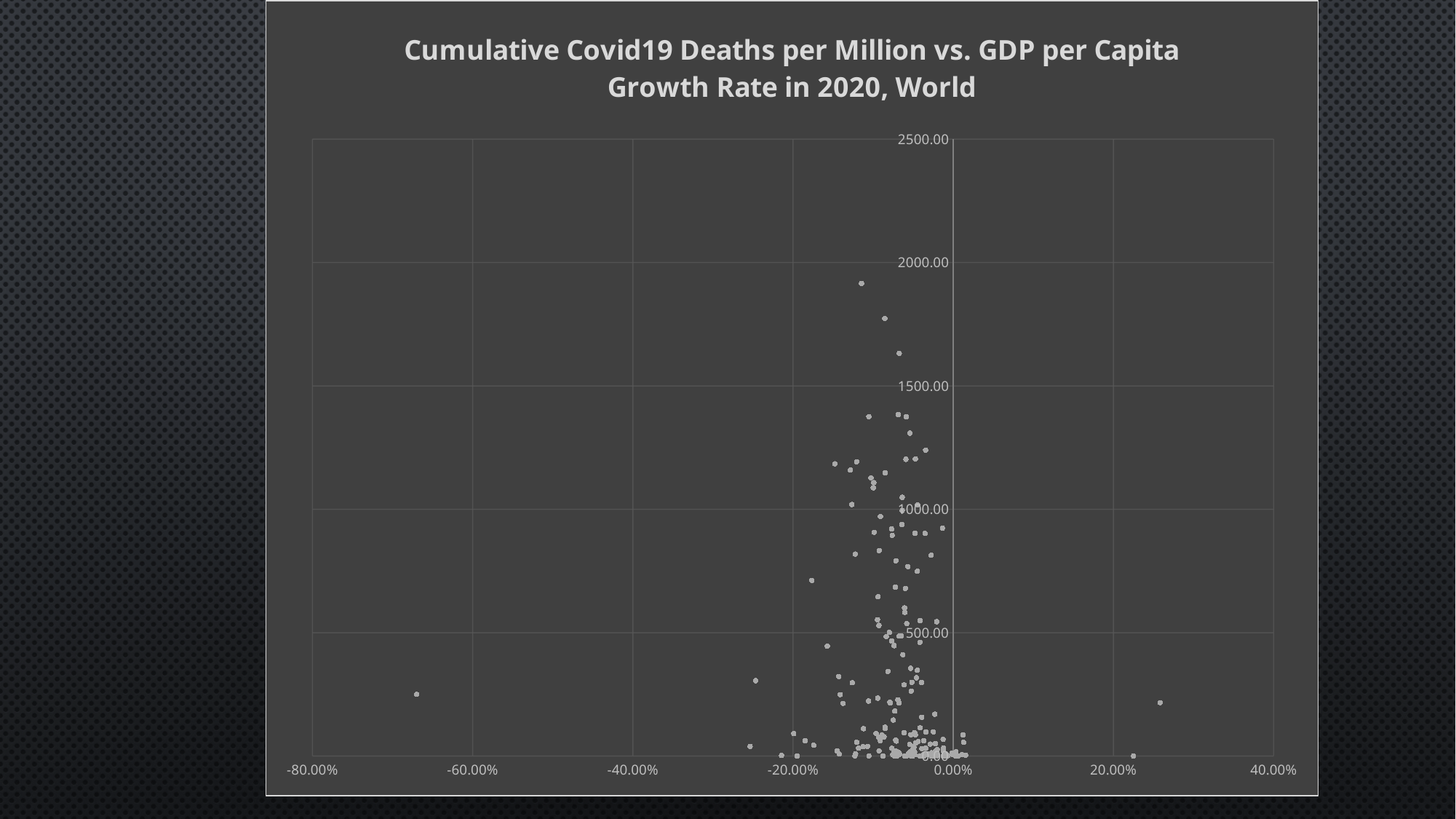
What kind of chart is shown on the slide? Scatter chart Is the deaths-per-million value of the leftmost point greater or less than 500? less Is the deaths-per-million value of the highest point on the chart greater or less than 1500? greater Is the GDP per capita growth rate of the rightmost point greater or less than 20.00%? greater What is the title of the chart? Cumulative Covid19 Deaths per Million vs. GDP per Capita Growth Rate in 2020, World What is the highest value labelled on the vertical axis? 2500.00